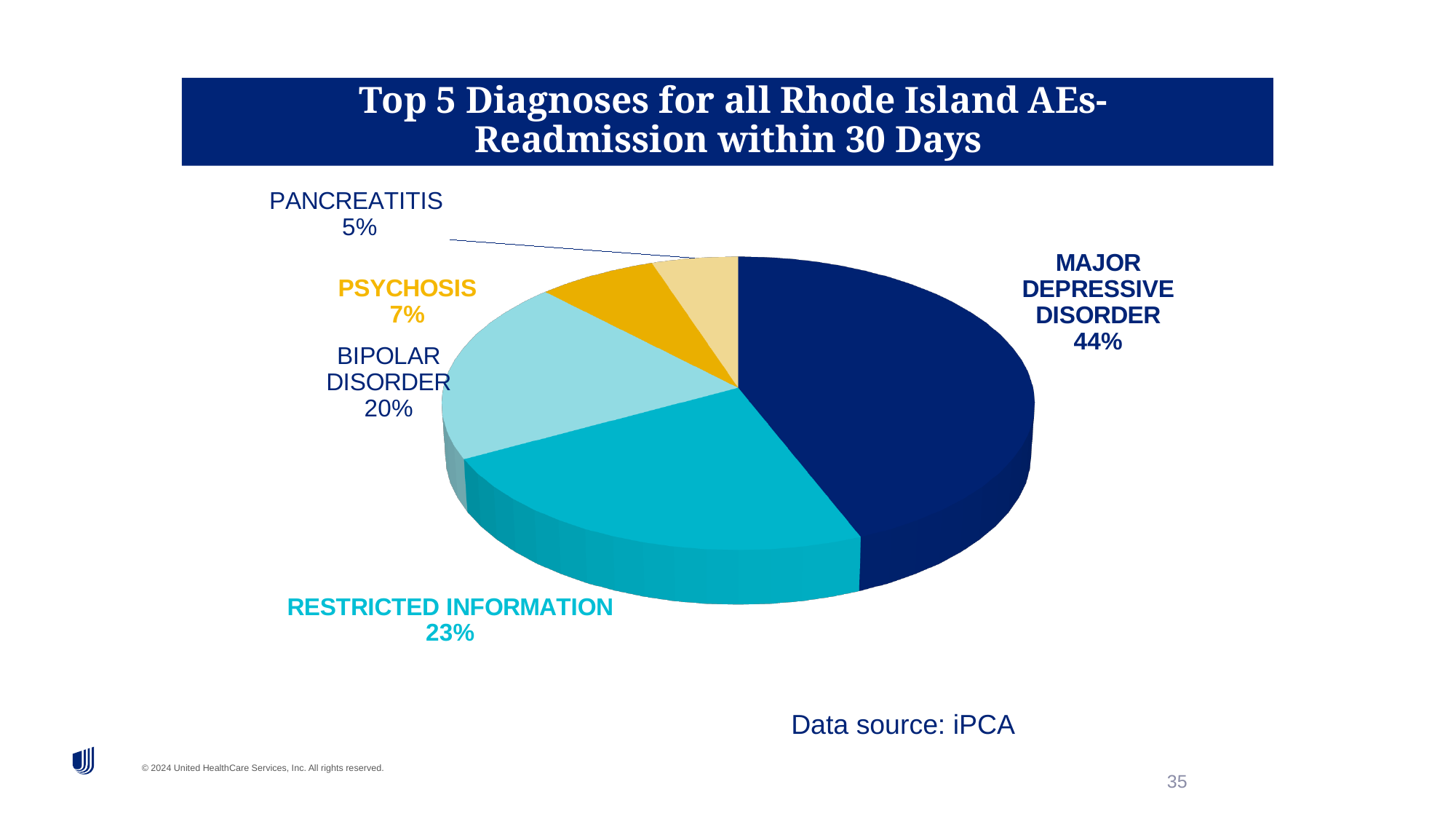
What percentage is shown for Psychosis? 7% What percentage is shown for Pancreatitis? 5% Which diagnosis has the largest slice of the pie? Major Depressive Disorder Which diagnosis has the smallest slice of the pie? Pancreatitis What is the title of the chart? Top 5 Diagnoses for all Rhode Island AEs- Readmission within 30 Days What share of the pie does Major Depressive Disorder account for? 44% What percentage is shown for Bipolar Disorder? 20% What is the difference in percentage points between Major Depressive Disorder and Restricted Information? 21 Which is larger, the share for Bipolar Disorder or the share for Psychosis? Bipolar Disorder How many diagnoses are shown in the pie chart? 5 What kind of chart is shown on the slide? Pie chart What percentage is shown for Restricted Information? 23%